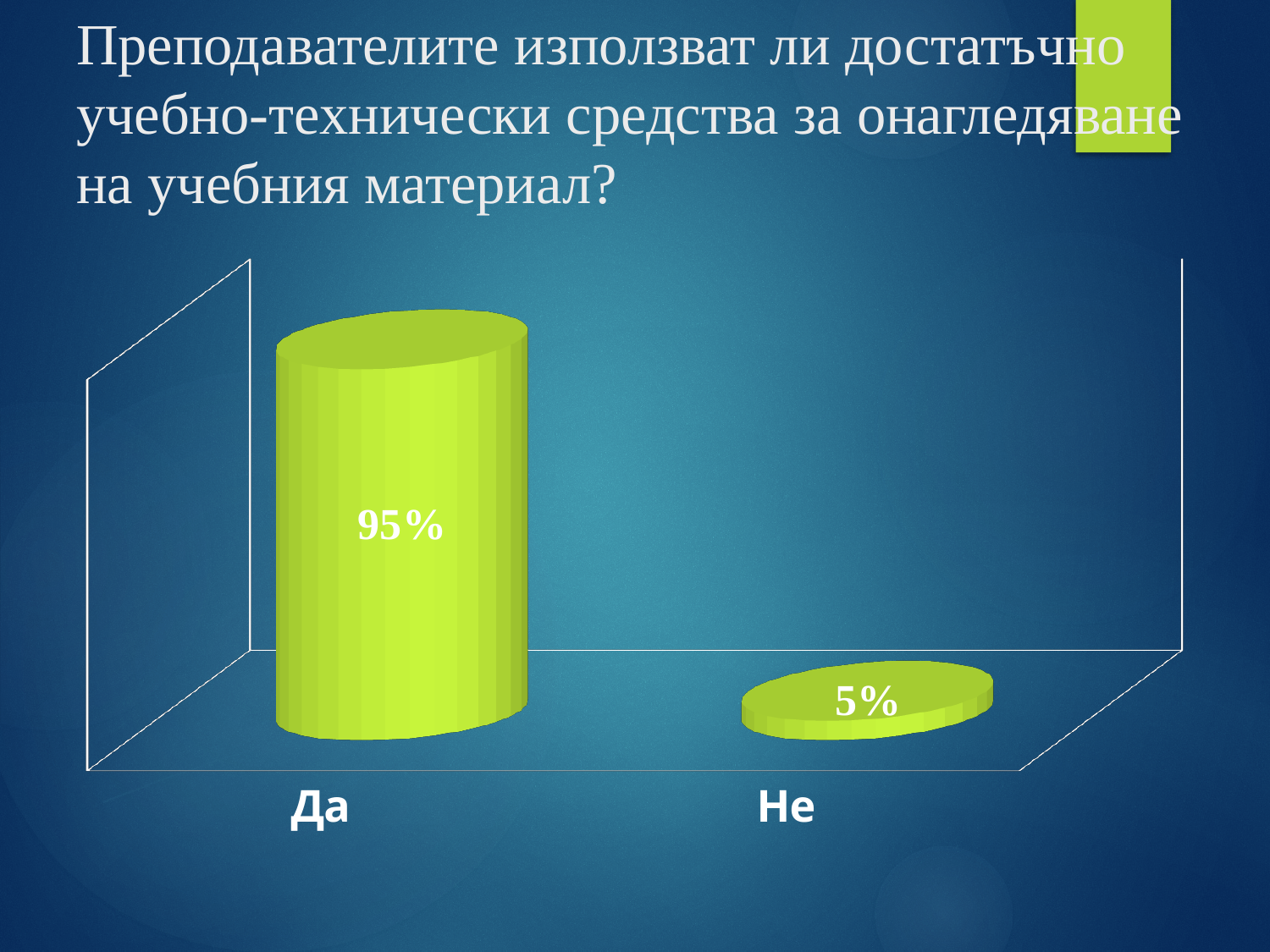
Which is larger, the value for Да or the value for Не? Да What is the difference between the values for Да and Не? 90% Which category has the lowest value? Не Which category has the highest value? Да What is the value for Не? 5% What is the label of the first category on the x axis? Да Do the values rise or fall from Да to Не? fall How many categories are shown in the chart? 2 What is the total of the two values shown in the chart? 100% What is the value for Да? 95% What kind of chart is shown on the slide? bar chart What colour are the bars in the chart? green